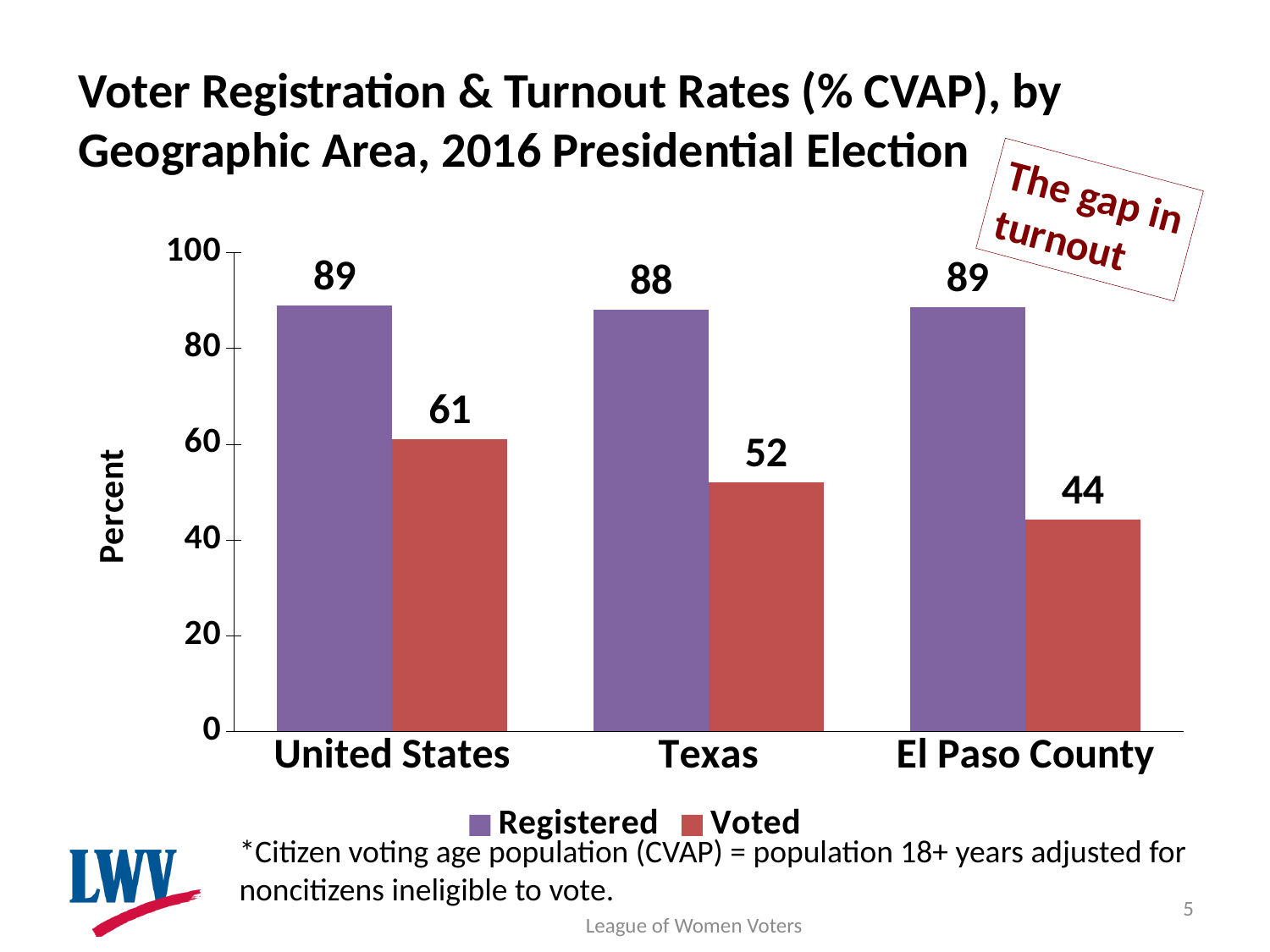
What is the Voted value for the United States? 61 What is the difference between the Voted values for the United States and Texas? 9 What is the label on the vertical axis? Percent What is the Registered value for Texas? 88 Which geographic area has the lowest Voted value? El Paso County How many series does the legend list? 2 Which geographic area has the highest Voted value? United States What is the difference between the Registered and Voted values for El Paso County? 45 What is the Voted value for El Paso County? 44 How many geographic areas are shown on the x axis? 3 What kind of chart is shown on the slide? Bar chart Which is larger, the Voted value for Texas or the Voted value for El Paso County? Texas